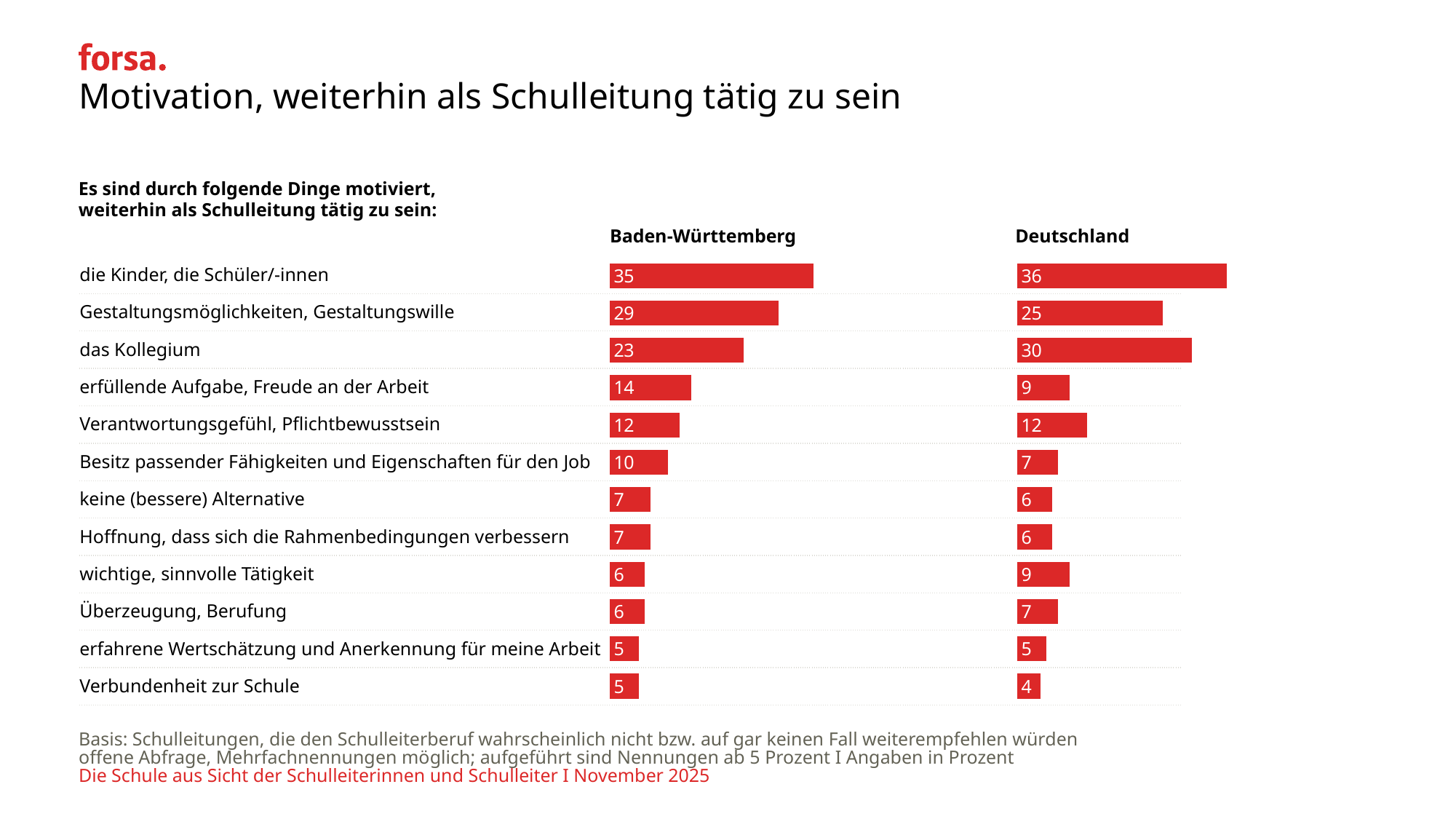
In the Deutschland chart, which category has the highest value? die Kinder, die Schüler/-innen What colour are the bars in both charts? red In the Deutschland chart, what is the value for "wichtige, sinnvolle Tätigkeit"? 9 How many categories are shown in the Baden-Württemberg chart? 12 In the Baden-Württemberg chart, what is the value for "das Kollegium"? 23 What is the difference between the Deutschland and Baden-Württemberg values for "das Kollegium"? 7 In the Deutschland chart, which category has the lowest value? Verbundenheit zur Schule In the Baden-Württemberg chart, which category has the highest value? die Kinder, die Schüler/-innen In the Deutschland chart, what is the value for "Gestaltungsmöglichkeiten, Gestaltungswille"? 25 In the Baden-Württemberg chart, what is the difference between "die Kinder, die Schüler/-innen" and "Gestaltungsmöglichkeiten, Gestaltungswille"? 6 For "erfüllende Aufgabe, Freude an der Arbeit", which is larger: the Baden-Württemberg value or the Deutschland value? Baden-Württemberg What kind of chart is used for the Deutschland data? bar chart